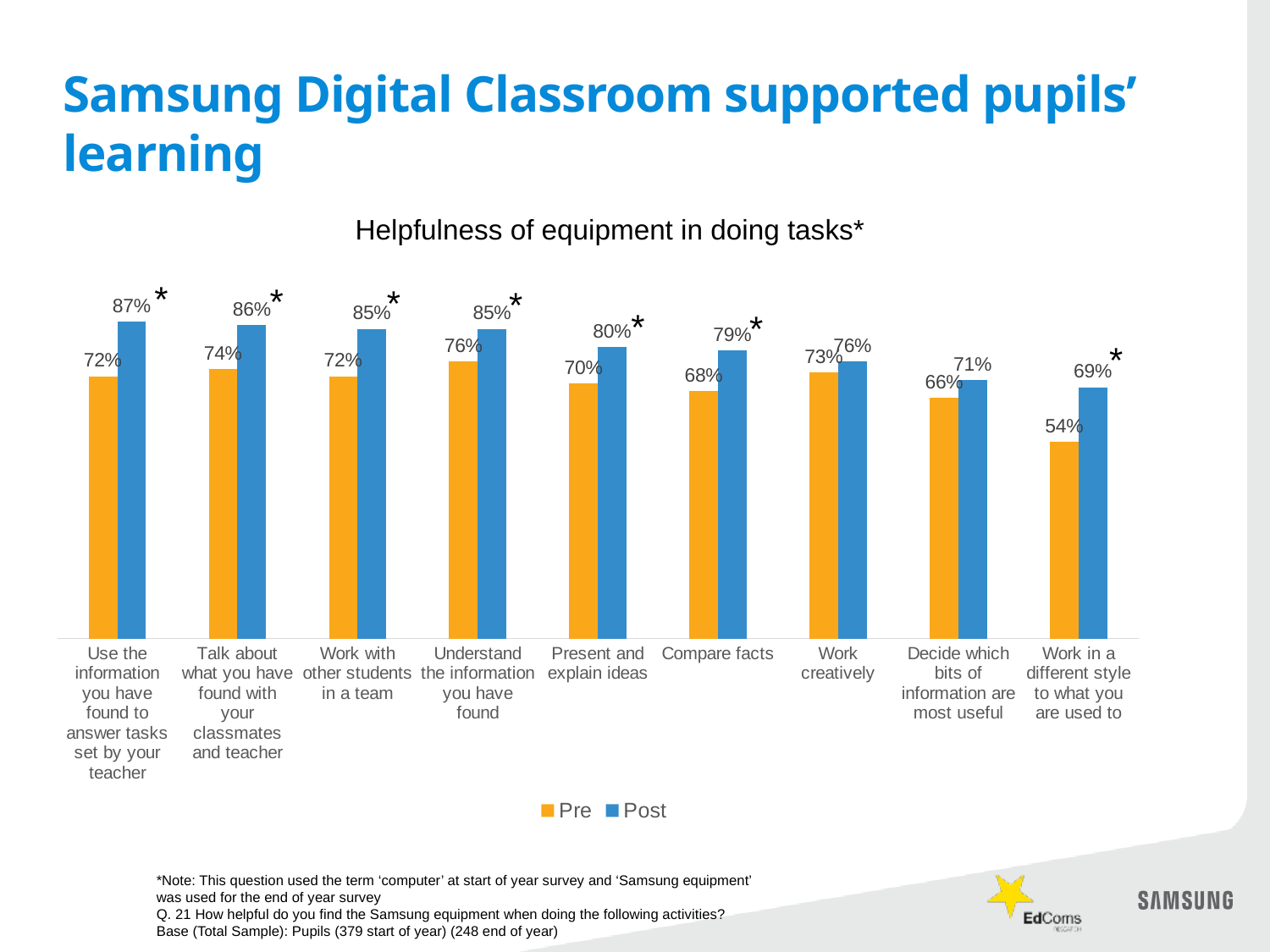
What is the difference between the Post and Pre values for "Present and explain ideas"? 10% What is the Pre value for "Work in a different style to what you are used to"? 54% How many series does the legend list? 2 What is the Pre value for "Understand the information you have found"? 76% Which is larger for "Decide which bits of information are most useful": the Pre value or the Post value? Post Which category has the highest Post value? Use the information you have found to answer tasks set by your teacher How many categories are shown on the x axis? 9 What is the Post value for "Compare facts"? 79% What is the difference between the Post and Pre values for "Work in a different style to what you are used to"? 15% What is the title of the chart? Helpfulness of equipment in doing tasks* Which category has the lowest Pre value? Work in a different style to what you are used to What kind of chart is shown on the slide? Bar chart